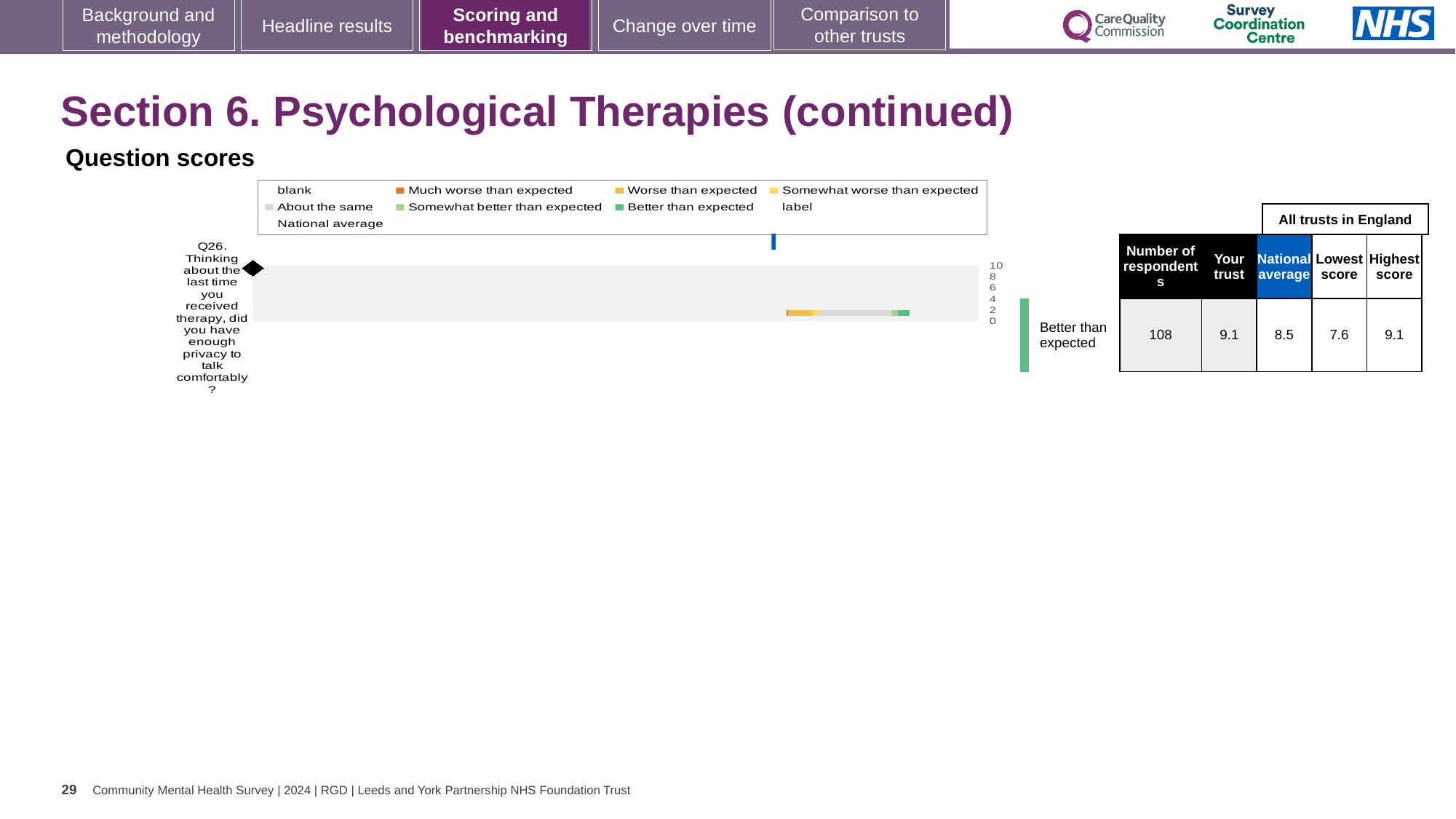
What is the 'Your trust' score for Q26? 9.1 What is the difference between the highest and lowest scores among all trusts in England for Q26? 1.5 What kind of chart is used for the Question scores? bar chart What is the highest score among all trusts in England for Q26? 9.1 Which question is shown on the Question scores chart? Q26. Thinking about the last time you received therapy, did you have enough privacy to talk comfortably? Which is larger for Q26, the 'Your trust' score or the national average? Your trust What is the national average score for Q26? 8.5 How many questions are plotted on the Question scores chart? 1 How many respondents answered Q26? 108 What benchmark category is shown next to the bar for Q26? Better than expected What is the lowest score among all trusts in England for Q26? 7.6 What is the difference between the 'Your trust' score and the national average for Q26? 0.6